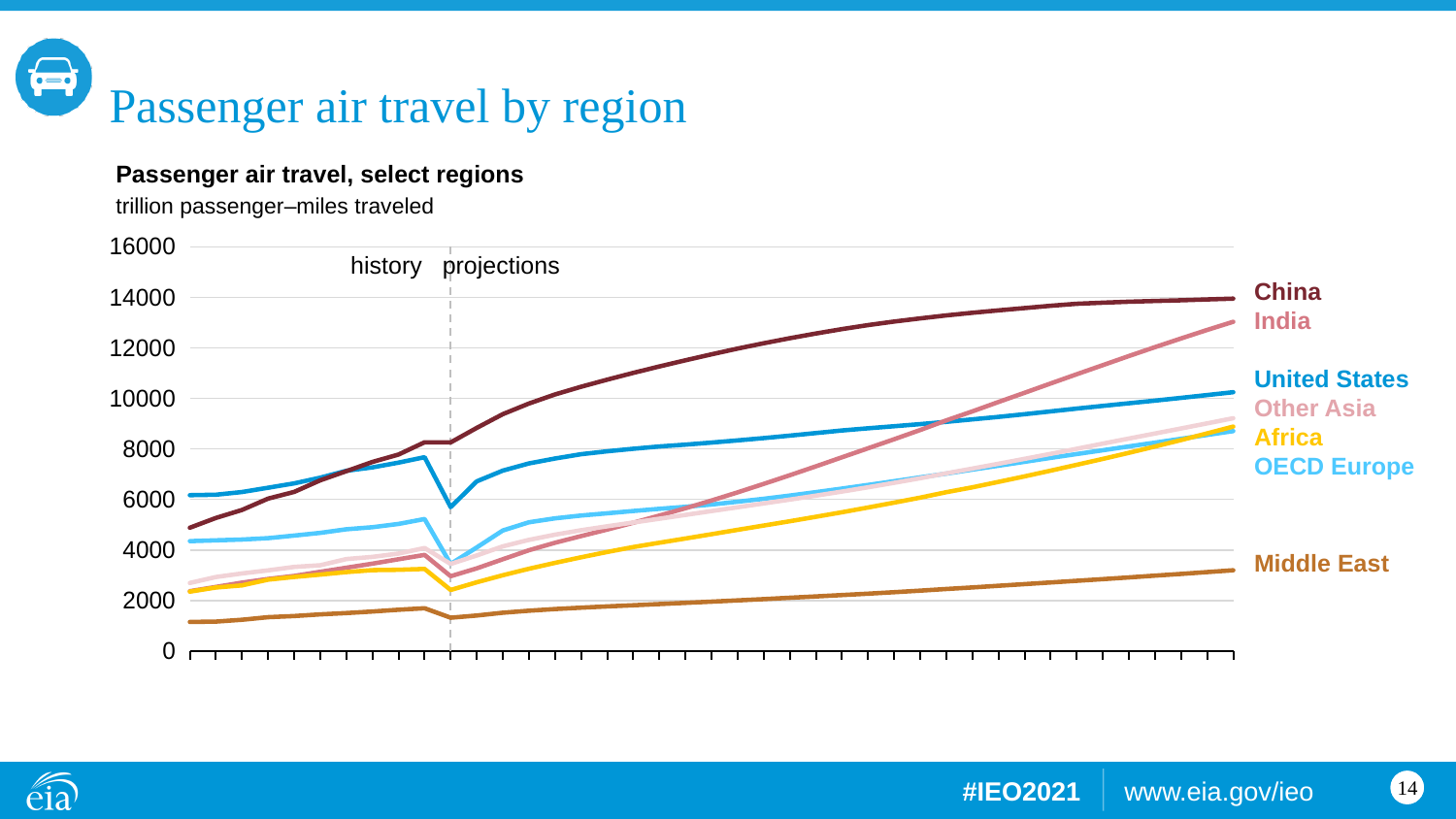
What kind of chart is shown on the slide? line chart What is the title of the chart? Passenger air travel, select regions At the end of the projection period, which is larger: India or United States? India What unit is the chart measured in? trillion passenger–miles traveled At the end of the projection period, which is larger: Africa or Middle East? Africa Which region has the lowest passenger air travel throughout the chart? Middle East Which region has the highest passenger air travel at the end of the projection period? China Is the value for Middle East at the end of the projection period greater or less than 4000? less Does the line for China rise or fall over the projection period? rise Is the value for China at the end of the projection period greater or less than 12000? greater How many regions (series) are plotted on the chart? 7 Is the value for India at the end of the projection period greater or less than 12000? greater